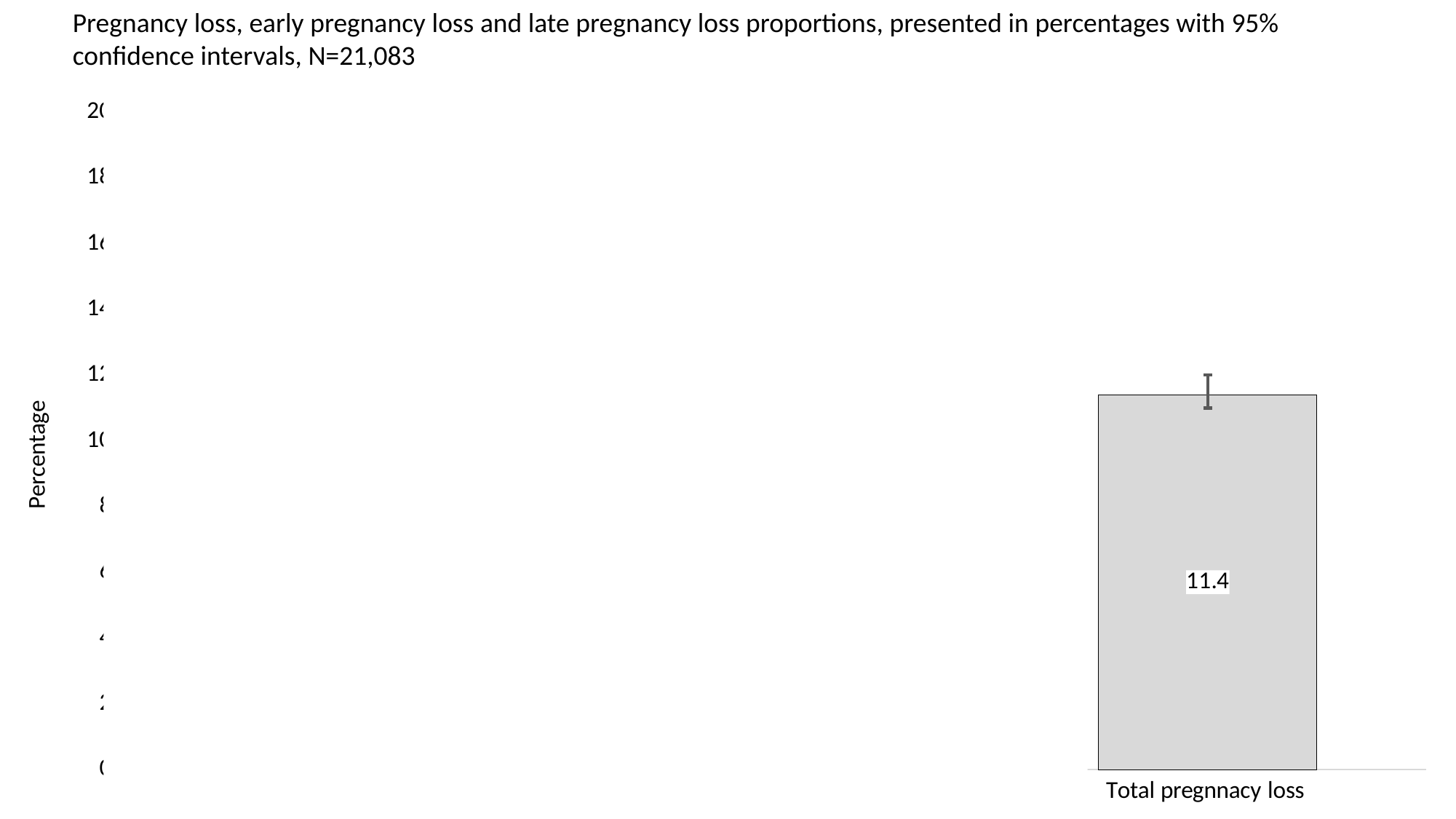
What sample size (N) is stated in the chart title? N=21,083 What is the label of the vertical axis? Percentage What kind of chart is shown on the slide? bar chart How many bars are plotted on the chart? 1 Is the value for Total pregnnacy loss greater or less than 10? greater Is the value for Total pregnnacy loss greater or less than 14? less What is the value shown for Total pregnnacy loss? 11.4 What is the category label of the plotted bar? Total pregnnacy loss